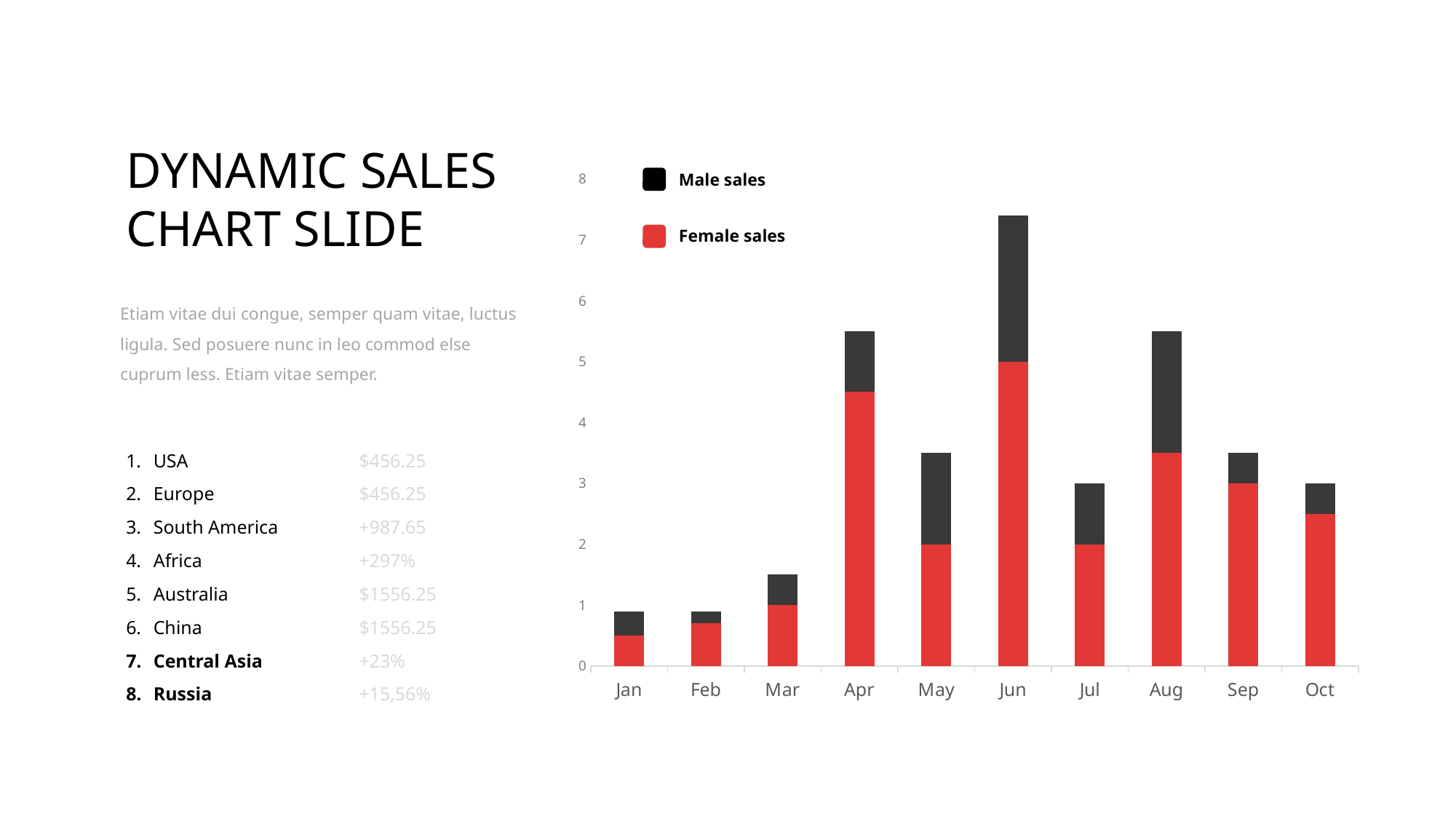
Is the total stacked value for Jan greater or less than 1? less How many months are shown along the x axis of the chart? 10 What is the Female sales value for Jun? 5 Which month has the highest Female sales value? Jun Which month has the highest total stacked bar? Jun Is the total stacked value for Jun greater or less than 7? greater How many series does the chart legend list? 2 What kind of chart is shown on the slide? bar chart Do the total stacked values rise or fall from Jan to Jun? rise What is the Female sales value for Mar? 1 What colour represents Female sales in the chart legend? red Which month has the larger total stacked bar, Apr or May? Apr